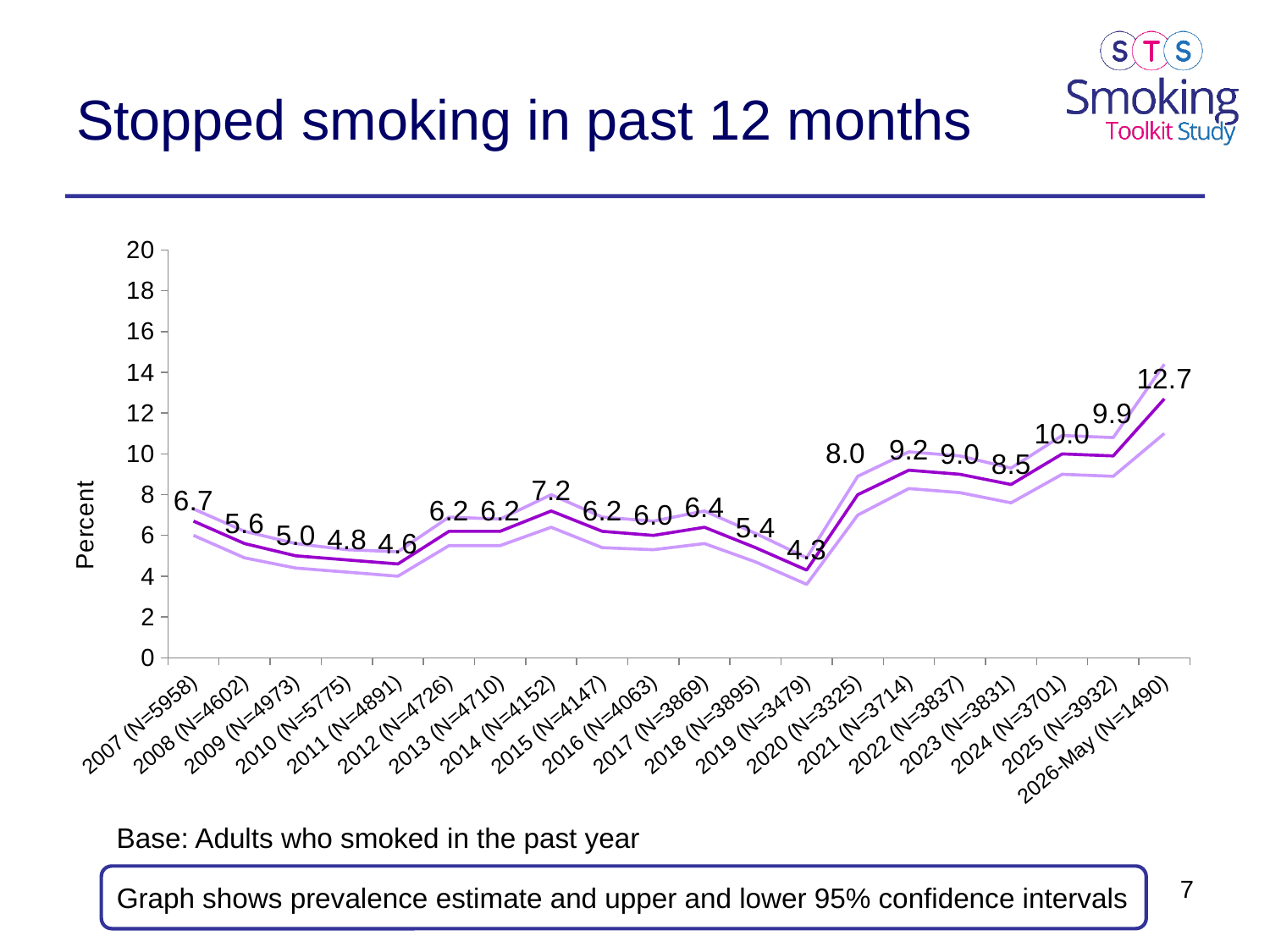
What is the label on the y axis? Percent Does the prevalence estimate rise or fall from 2007 to 2011? Fall What type of chart is shown on the slide? Line chart What is the prevalence estimate for 2019 (N=3479)? 4.3 What is the difference between the prevalence estimates for 2020 and 2019? 3.7 What is the prevalence estimate for 2024 (N=3701)? 10.0 How many years (data points) are plotted on the x axis? 20 What is the prevalence estimate for 2007 (N=5958)? 6.7 Which year has the highest prevalence estimate? 2026-May (N=1490) Which year has the lowest prevalence estimate? 2019 (N=3479) Which is larger, the prevalence estimate for 2014 or for 2007? 2014 What is the difference between the prevalence estimates for 2026-May and 2025? 2.8